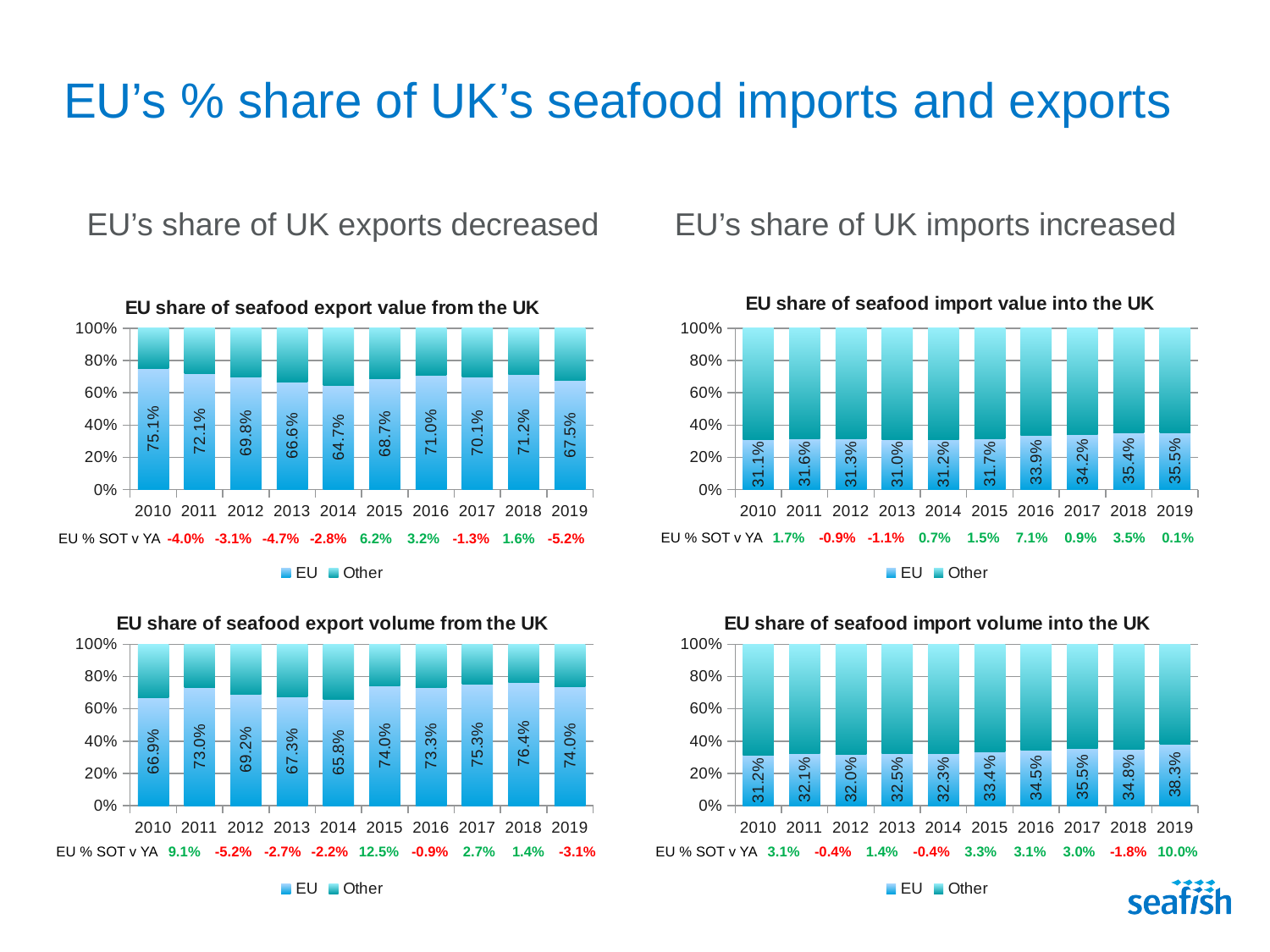
In the 'EU share of seafood export value from the UK' chart, which year has the lowest EU share? 2014 In the 'EU share of seafood import volume into the UK' chart, which year has the highest EU share? 2019 In the 'EU share of seafood import volume into the UK' chart, what is the EU share in 2013? 32.5% In the 'EU share of seafood export value from the UK' chart, what is the difference in EU share between 2010 and 2014? 10.4 percentage points In the 'EU share of seafood export volume from the UK' chart, what is the EU share in 2015? 74.0% In the 'EU share of seafood export volume from the UK' chart, which year has the highest EU share? 2018 How many years are shown on the x axis of the 'EU share of seafood import value into the UK' chart? 10 What kind of chart is the 'EU share of seafood import value into the UK' chart? Stacked bar chart How many series does the legend of the 'EU share of seafood export volume from the UK' chart list? 2 In the 'EU share of seafood import volume into the UK' chart, is the EU share larger in 2019 or in 2010? 2019 In the 'EU share of seafood import value into the UK' chart, what is the EU share in 2019? 35.5% In the 'EU share of seafood export value from the UK' chart, what is the EU share in 2010? 75.1%